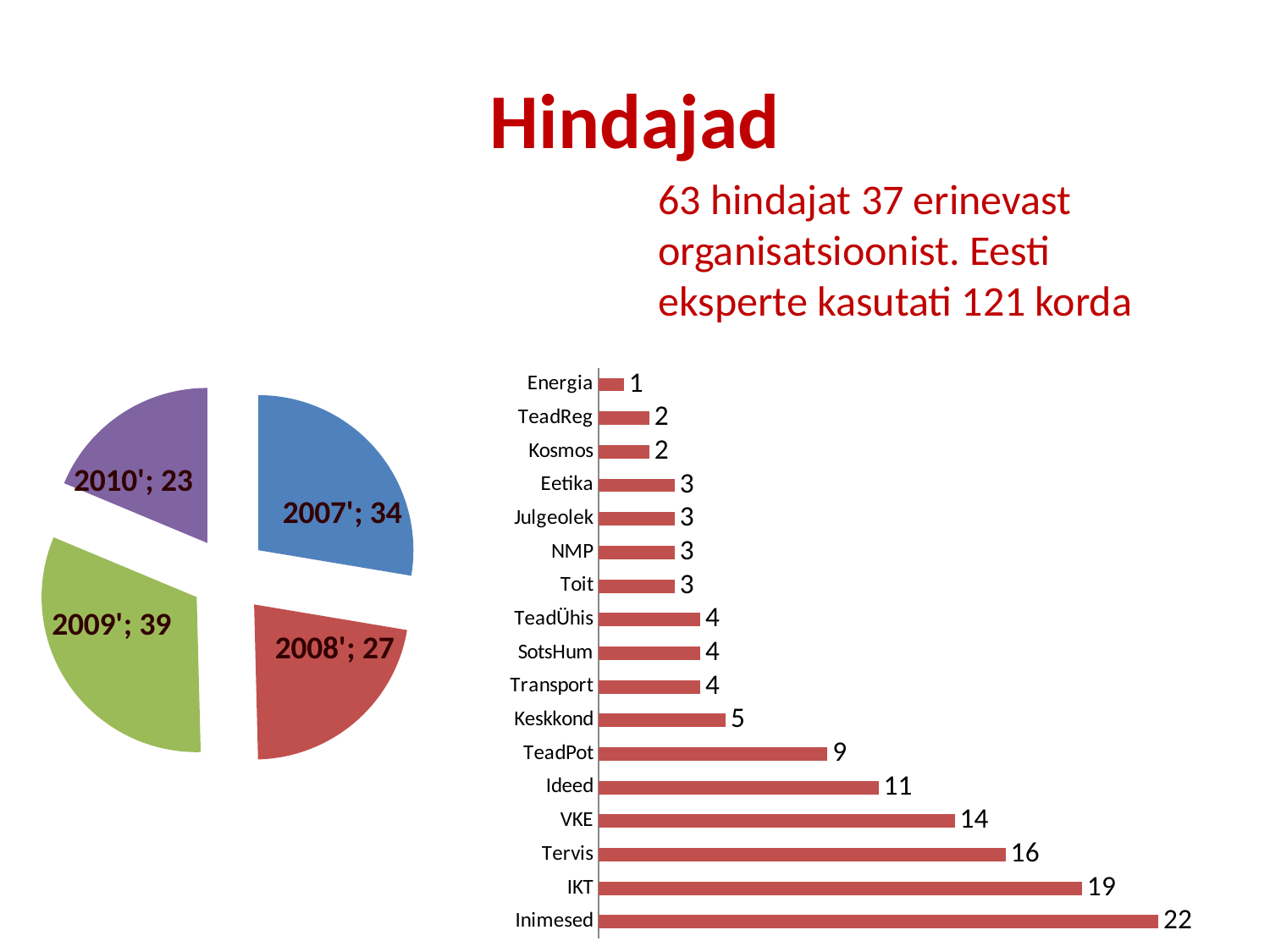
In the pie chart on the left, which year has the smallest slice? 2010' How many slices does the pie chart on the left have? 4 In the bar chart on the right, what is the value for VKE? 14 In the bar chart on the right, what is the difference between the values for IKT and Tervis? 3 What kind of chart is the chart on the right of the slide? bar chart In the pie chart on the left, what is the value for 2009'? 39 In the bar chart on the right, which category has the lowest value? Energia In the bar chart on the right, what is the value for Inimesed? 22 In the bar chart on the right, which is larger, the value for Ideed or the value for TeadPot? Ideed How many categories are shown in the bar chart on the right? 17 In the pie chart on the left, what is the difference between the values for 2007' and 2008'? 7 In the bar chart on the right, which category has the highest value? Inimesed